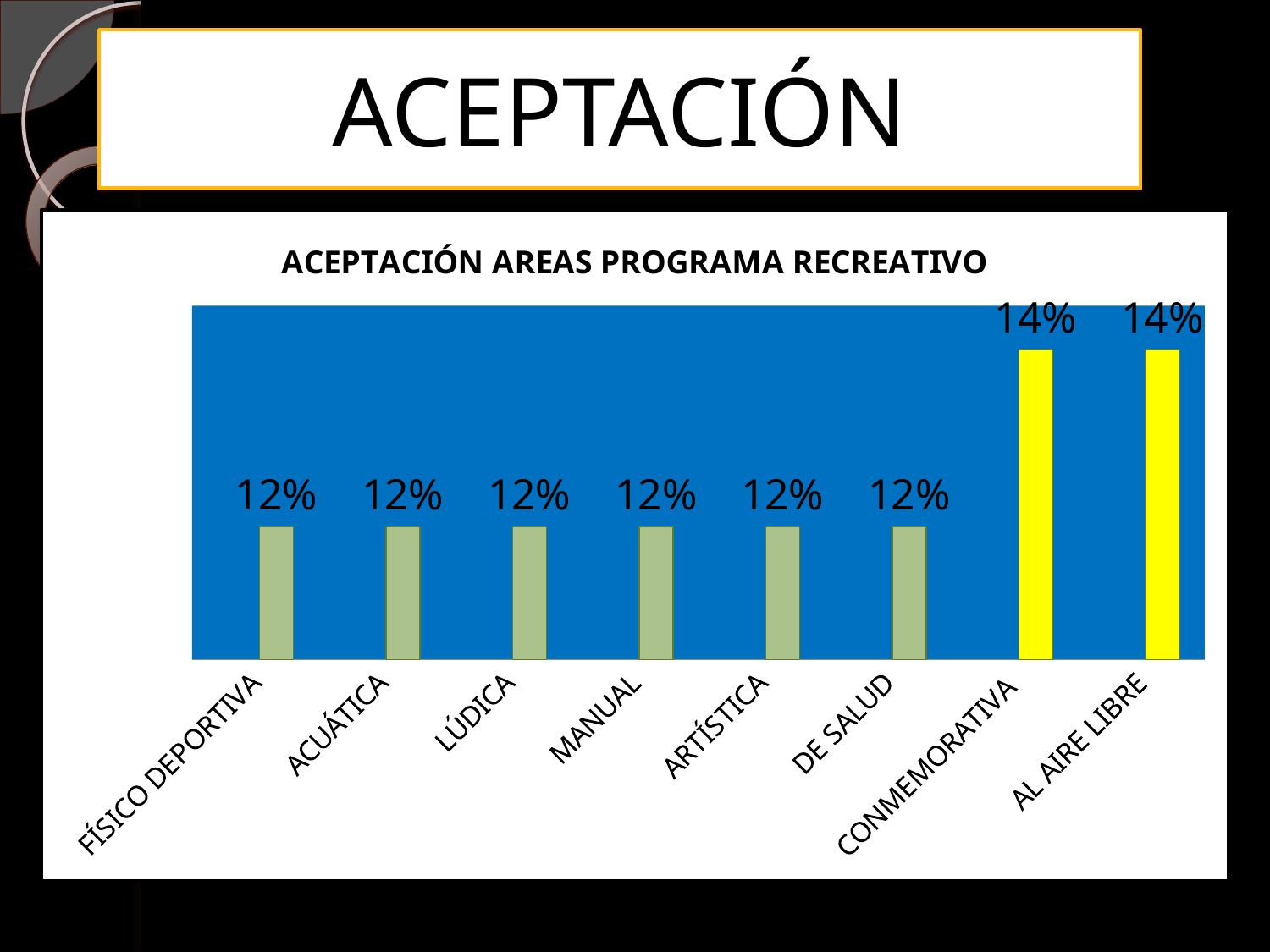
How many categories have a value of 12%? 6 What is the value for CONMEMORATIVA? 14% How many categories have a value of 14%? 2 What is the value for AL AIRE LIBRE? 14% What is the value for FÍSICO DEPORTIVA? 12% Which value is larger, DE SALUD or AL AIRE LIBRE? AL AIRE LIBRE What colour are the bars for CONMEMORATIVA and AL AIRE LIBRE? Yellow What is the difference between the values for CONMEMORATIVA and MANUAL? 2% What is the value for LÚDICA? 12% How many categories are shown on the x axis? 8 What kind of chart is shown? Bar chart What is the title of the chart? ACEPTACIÓN AREAS PROGRAMA RECREATIVO